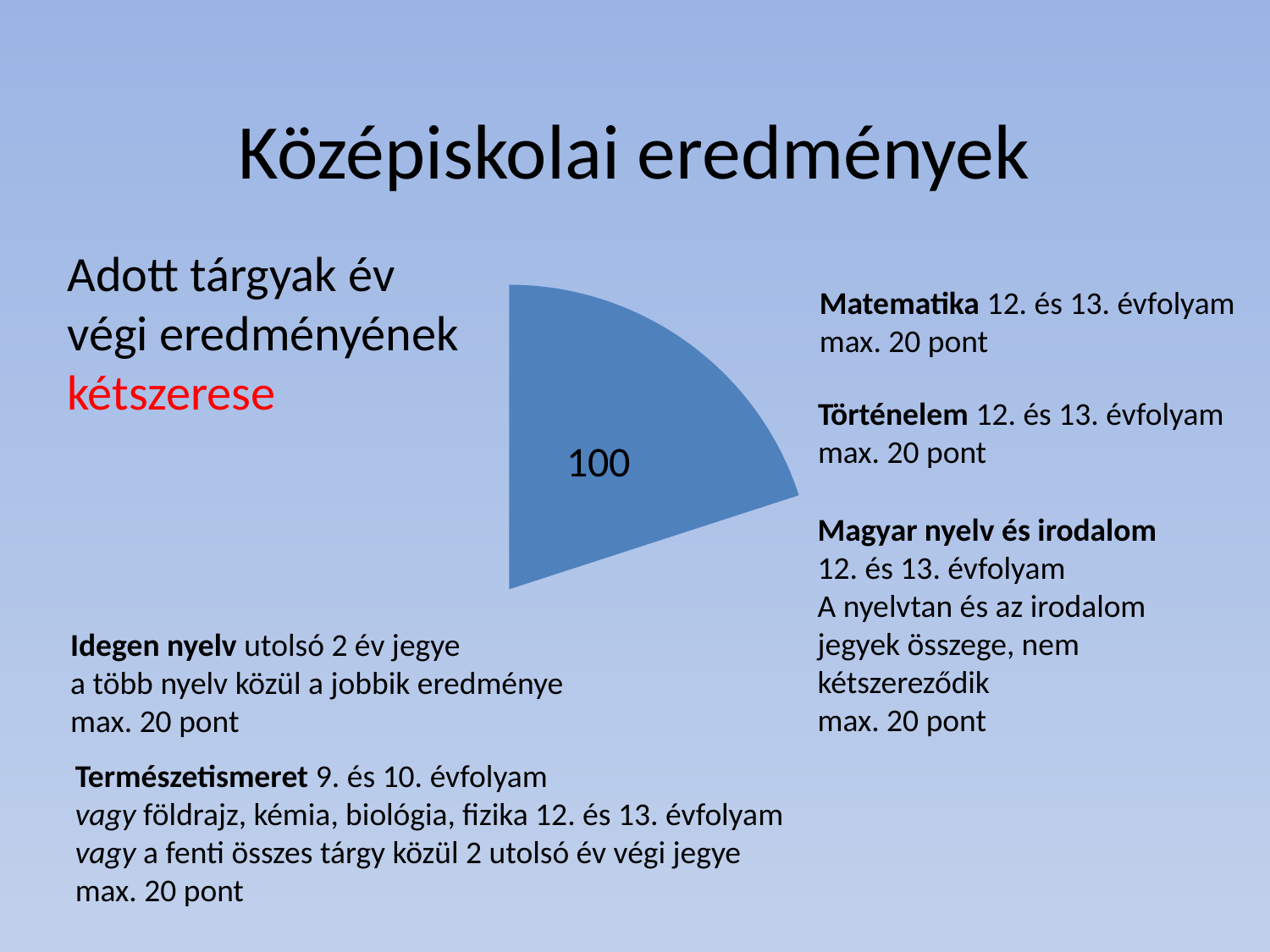
What kind of chart is shown on the slide? pie chart How many slices are shown in the pie chart? 1 What value is printed on the pie slice? 100 What colour is the pie slice? blue